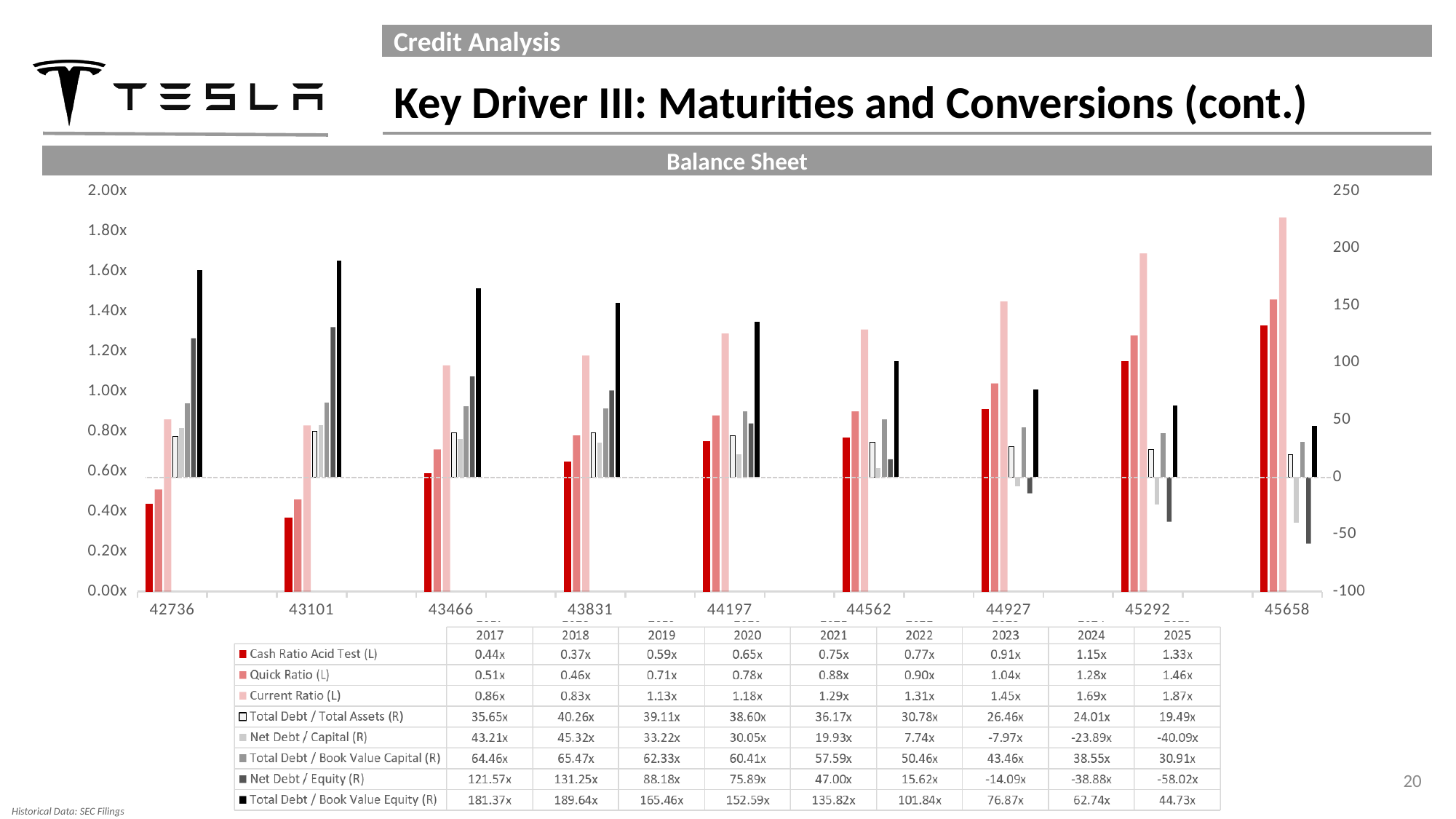
How many series does the legend list? 8 Does Total Debt / Total Assets (R) generally rise or fall from 2018 to 2025? Fall What is the Cash Ratio Acid Test (L) for 2018? 0.37x How many years are shown in the chart? 9 Which is larger, Net Debt / Capital (R) in 2017 or in 2018? 2018 What is the Net Debt / Equity (R) value for 2019? 88.18x In which year is Total Debt / Book Value Equity (R) highest? 2018 What is the difference between the Current Ratio (L) in 2025 and in 2017? 1.01x What kind of chart is shown on the slide? Bar chart What is the Current Ratio (L) for 2025? 1.87x In which year is the Quick Ratio (L) lowest? 2018 What is the title shown above the chart? Balance Sheet